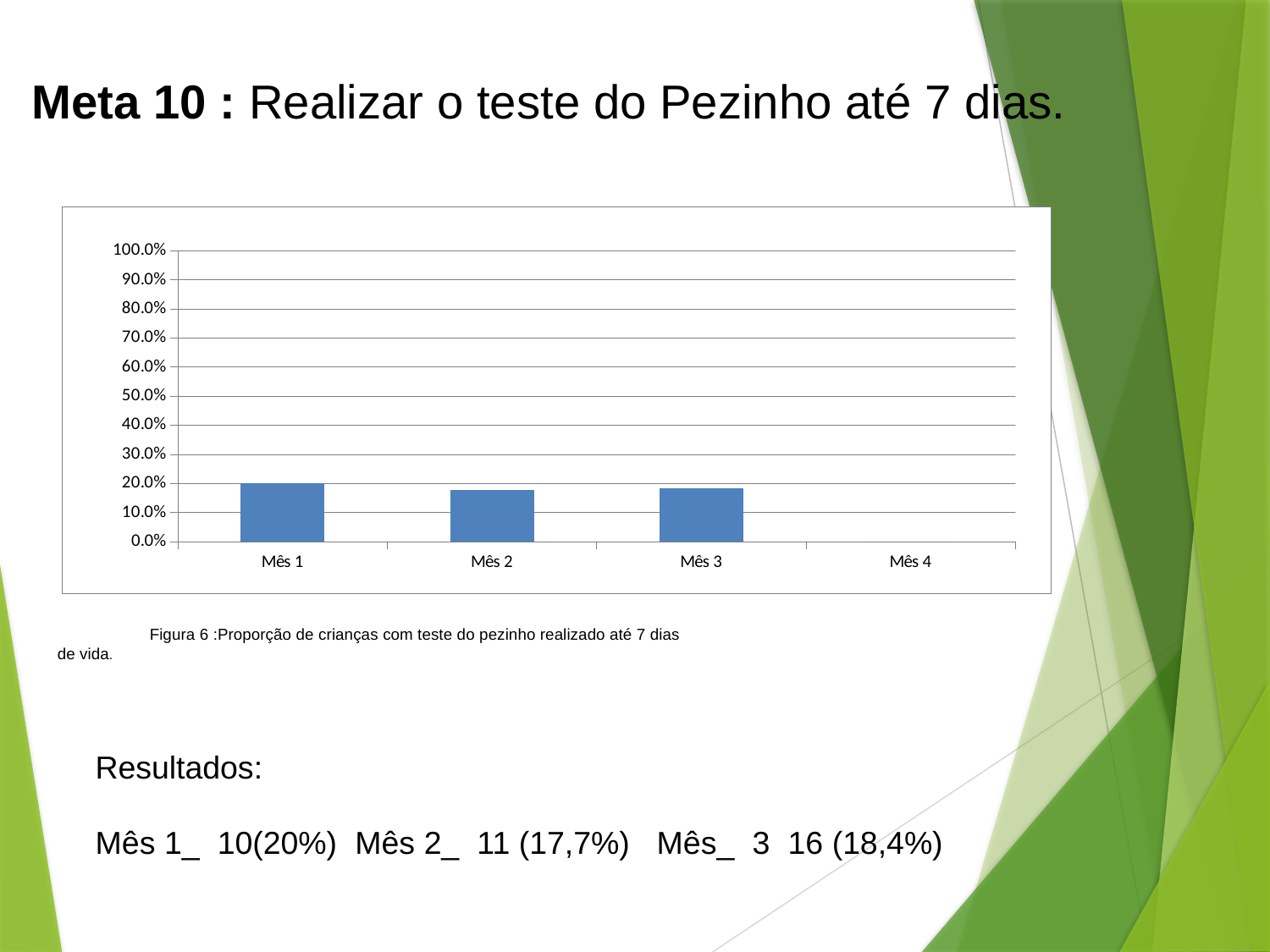
What kind of chart is shown on the slide? bar chart Is the value for Mês 2 greater or less than 20.0%? less Is the value for Mês 3 greater or less than 10.0%? greater Which category on the x axis has no bar plotted? Mês 4 Is the value for Mês 1 greater or less than 10.0%? greater Which of Mês 1 and Mês 2 has the larger value? Mês 1 How many categories are shown on the x axis of the chart? 4 Do the bar values rise or fall from Mês 1 to Mês 2? fall What is the value for Mês 1 in the chart? 20.0% What is the highest value shown on the y axis of the chart? 100.0% Which month has the highest bar in the chart? Mês 1